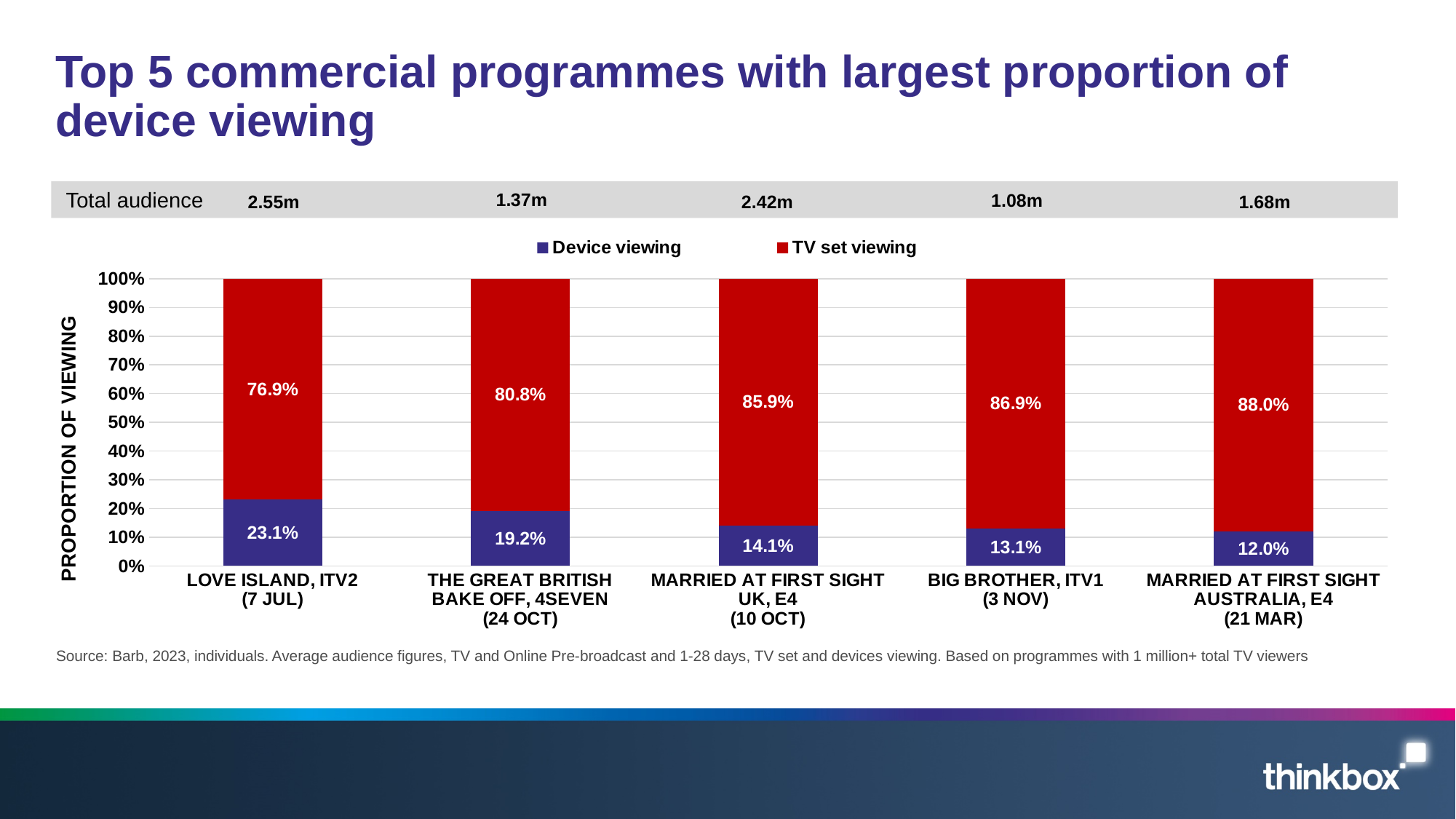
Is the Device viewing value for BIG BROTHER, ITV1 greater or less than 20%? less How many series does the legend list? 2 What kind of chart is shown on the slide? Stacked bar chart Does the Device viewing proportion rise or fall from left to right across the programmes? Fall What is the Device viewing value for MARRIED AT FIRST SIGHT AUSTRALIA, E4 (21 MAR)? 12.0% Which programme has the highest Device viewing proportion? LOVE ISLAND, ITV2 (7 JUL) What is the TV set viewing value for BIG BROTHER, ITV1 (3 NOV)? 86.9% How many programmes are shown on the chart? 5 What is the Device viewing value for LOVE ISLAND, ITV2 (7 JUL)? 23.1% Which has a larger TV set viewing proportion: MARRIED AT FIRST SIGHT UK, E4 or THE GREAT BRITISH BAKE OFF, 4SEVEN? MARRIED AT FIRST SIGHT UK, E4 Which programme has the lowest TV set viewing proportion? LOVE ISLAND, ITV2 (7 JUL) What is the difference in Device viewing between LOVE ISLAND, ITV2 and THE GREAT BRITISH BAKE OFF, 4SEVEN? 3.9%